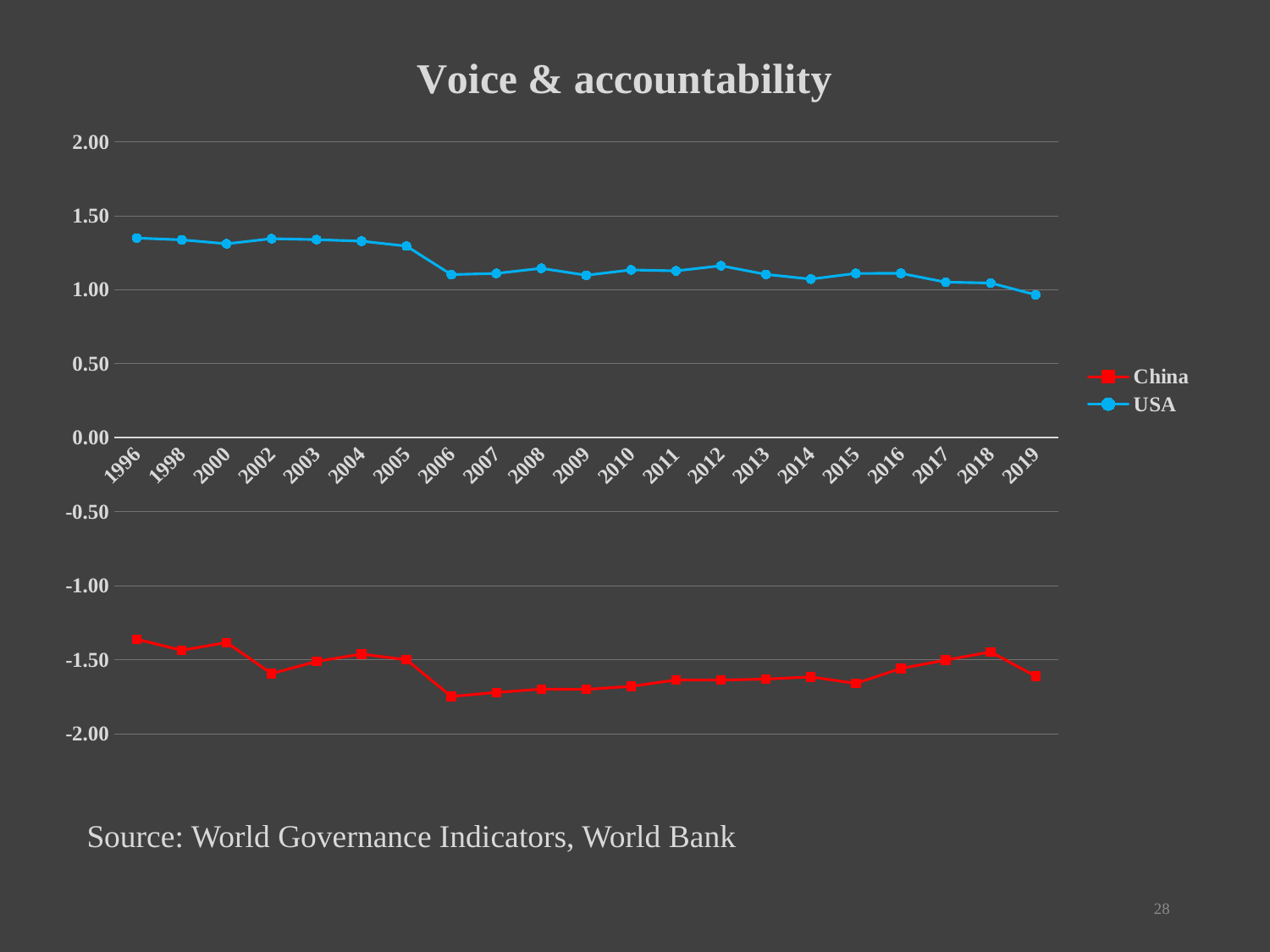
Which series is drawn in red? China In which year is the USA value lowest? 2019 Do the USA values generally rise or fall from 1996 to 2019? fall Is the value for USA in 1996 greater or less than 1.00? greater Is the value for China in 2006 greater or less than -1.50? less Which series has the higher value in 2010, China or USA? USA How many years are plotted along the x axis? 21 Is the value for USA in 2006 greater or less than 1.50? less How many series does the legend list? 2 What is the title of the chart? Voice & accountability What kind of chart is shown on the slide? Line chart